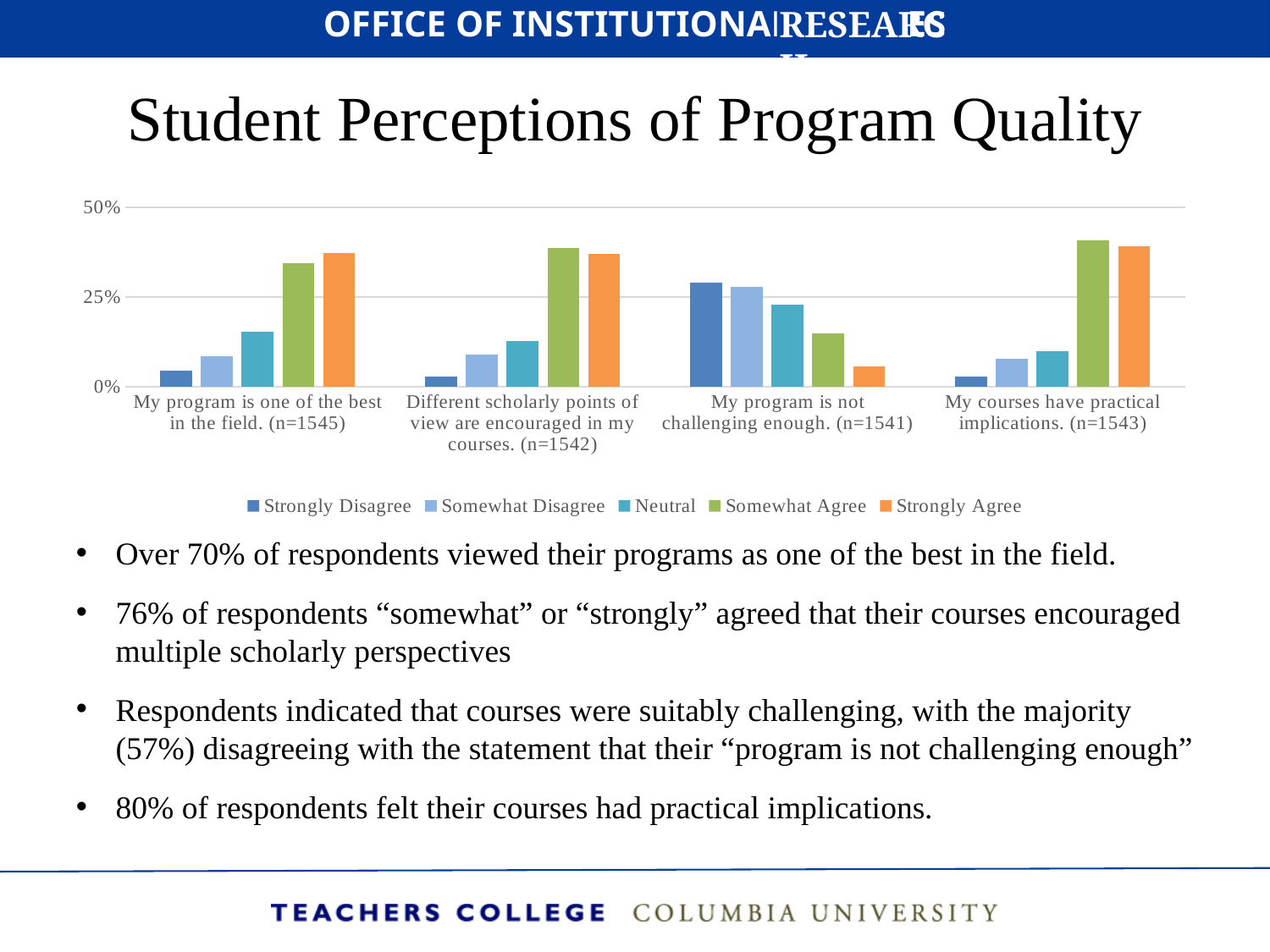
Which colour represents the Strongly Agree series in the chart? orange What kind of chart is shown on the slide? bar chart How many series does the chart's legend list? 5 What is the title of the chart on the slide? Student Perceptions of Program Quality For "My program is one of the best in the field", which response option has the lowest value? Strongly Disagree Is the Strongly Disagree value for "Different scholarly points of view are encouraged in my courses" greater or less than 25%? less Is the Somewhat Agree value for "My courses have practical implications" greater or less than 25%? greater Which is larger: the Neutral value for "My program is one of the best in the field" or the Neutral value for "My courses have practical implications"? My program is one of the best in the field Is the Strongly Agree value for "My program is one of the best in the field" greater or less than 25%? greater How many survey statements (categories) are shown on the x axis of the chart? 4 For "My program is not challenging enough", which response option has the lowest value? Strongly Agree